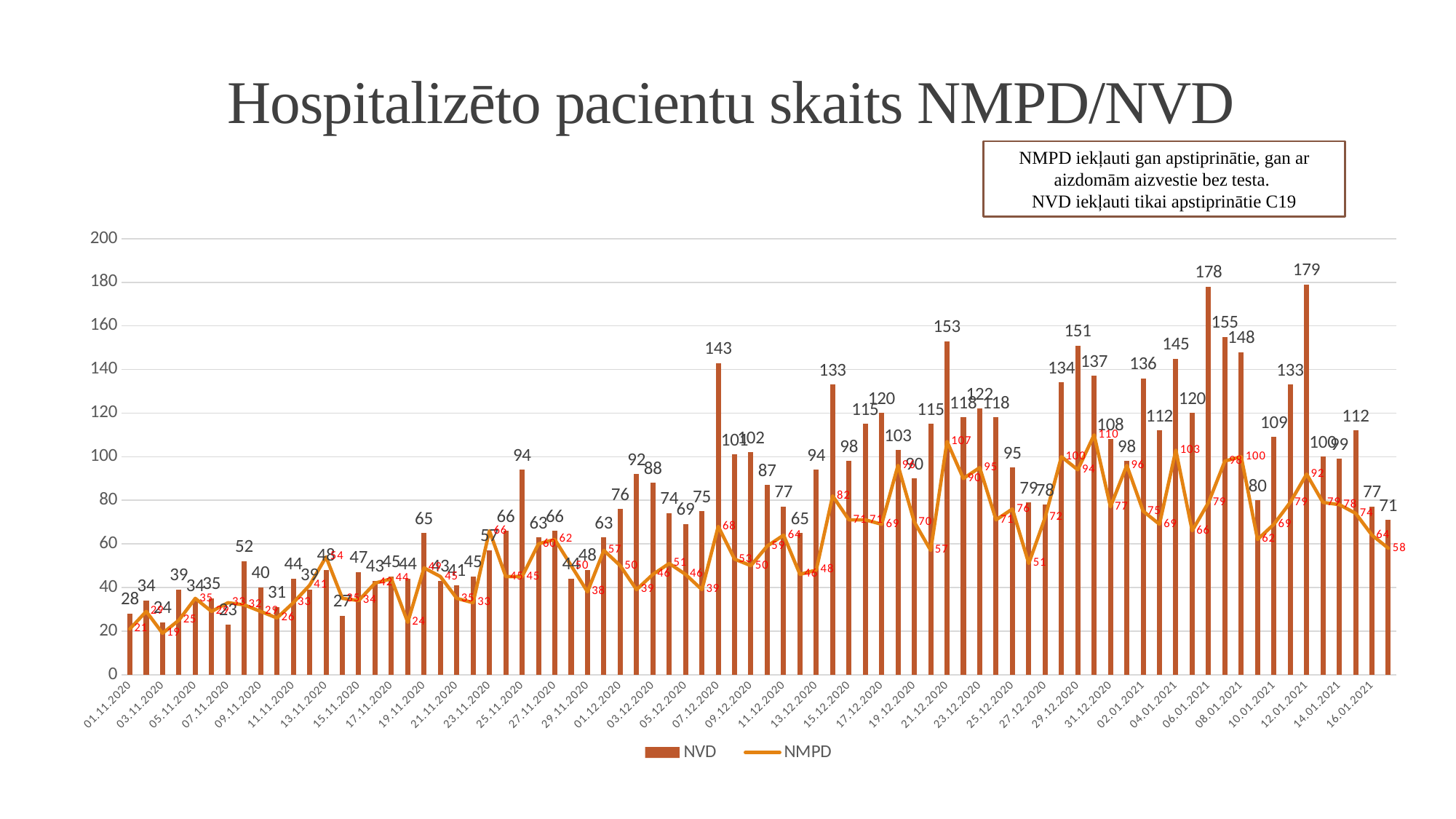
What is the lowest NVD value shown in the chart? 23 What is the highest NVD value shown in the chart? 179 What is the NVD value for 07.12.2020? 143 Overall, do the NVD values rise or fall from November 2020 to January 2021? Rise What is the title of the chart? Hospitalizēto pacientu skaits NMPD/NVD What is the NVD value for 01.11.2020? 28 What kind of chart is shown on the slide? A combined bar and line chart What is the NVD value for 06.01.2021? 178 What are the two series named in the legend? NVD and NMPD What is the highest NMPD value shown on the line? 110 What is the difference between the NVD values for 12.01.2021 (179) and 06.01.2021 (178)? 1 How many series does the legend list? 2